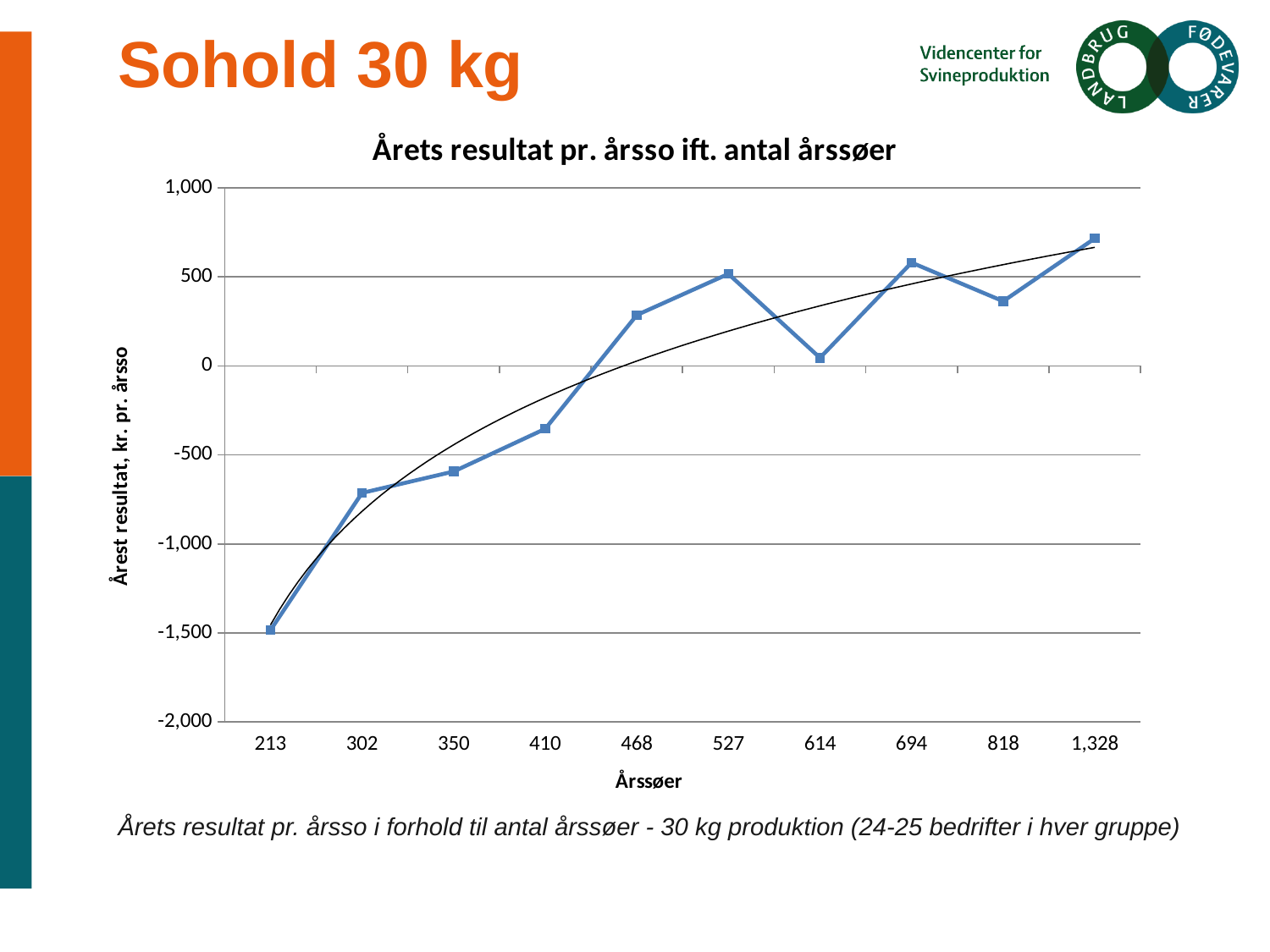
Is the value for 213 årssøer greater or less than -1,000? less Do the values generally rise or fall as the number of årssøer increases along the x axis? rise Is the value for 302 årssøer greater or less than -1,000? greater Which category has the highest årets resultat pr. årsso? 1,328 Is the value for 468 årssøer greater or less than 0? greater Which category has the lowest årets resultat pr. årsso? 213 How many categories (groups of årssøer) are plotted along the x axis? 10 What kind of chart is shown on the slide? line chart Which has the larger årets resultat pr. årsso: 527 or 614 årssøer? 527 What is the title of the chart? Årets resultat pr. årsso ift. antal årssøer